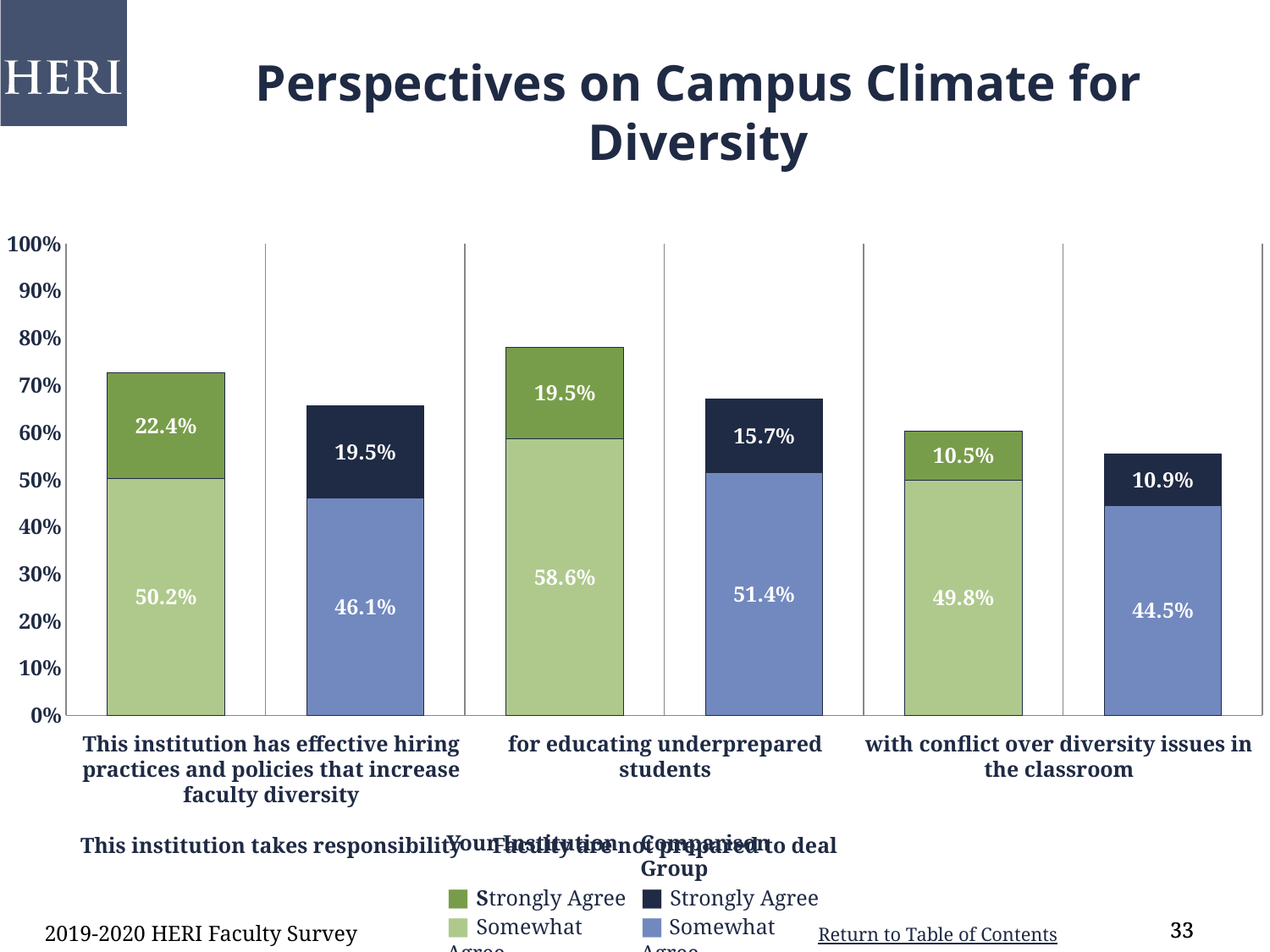
What kind of chart is shown on the slide? Stacked bar chart Which has the larger Strongly Agree percentage for the statement about conflict over diversity issues in the classroom, Your Institution or the Comparison Group? Comparison Group What percentage of Comparison Group faculty Strongly Agree with the statement about conflict over diversity issues in the classroom? 10.9% Which Somewhat Agree segment is the largest across all bars on the chart? 58.6% (Your Institution, educating underprepared students) What is the total percentage (Strongly Agree plus Somewhat Agree) for the Comparison Group on the statement about educating underprepared students? 67.1% Which colour represents Strongly Agree for the Comparison Group? Dark navy What is the total percentage (Strongly Agree plus Somewhat Agree) for Your Institution on the statement about effective hiring practices and policies that increase faculty diversity? 72.6% What percentage of Your Institution faculty Somewhat Agree with the statement about educating underprepared students? 58.6% How many entries does the legend list? 4 What percentage of Your Institution faculty Strongly Agree that this institution has effective hiring practices and policies that increase faculty diversity? 22.4% What percentage of Comparison Group faculty Somewhat Agree that this institution has effective hiring practices and policies that increase faculty diversity? 46.1% What is the difference between the Your Institution and Comparison Group Somewhat Agree percentages for the statement about educating underprepared students? 7.2%